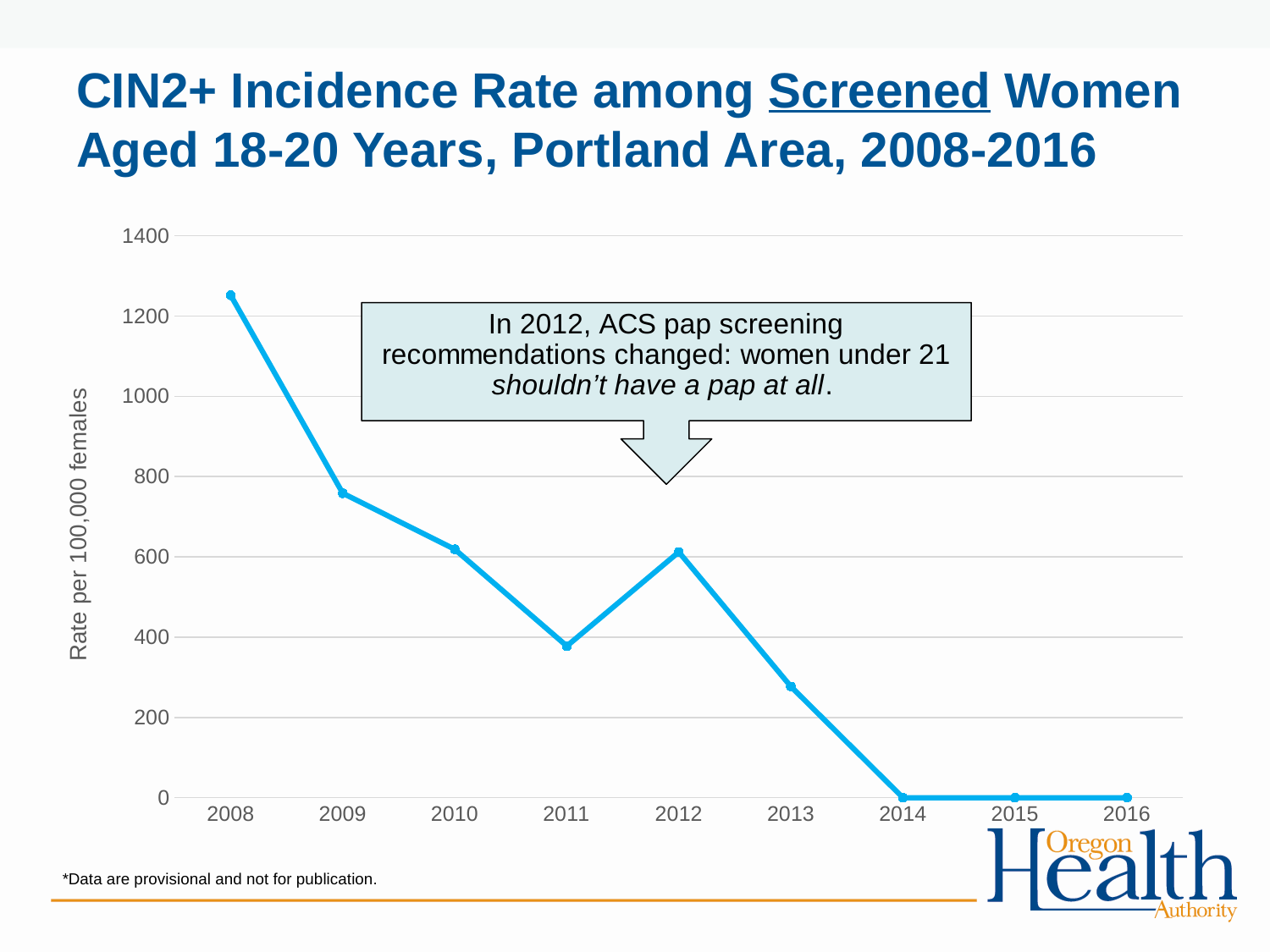
Is the value for 2011 greater or less than 400? less What is the CIN2+ incidence rate for 2016? 0 Is the value for 2013 greater or less than 200? greater Is the value for 2008 greater or less than 1200? greater What is the label on the y axis? Rate per 100,000 females Overall, do the values rise or fall from 2008 to 2016? fall How many years are plotted along the x axis? 9 What is the CIN2+ incidence rate for 2014? 0 What kind of chart is shown on the slide? line chart Which year has the larger value, 2011 or 2012? 2012 Which year has the highest CIN2+ incidence rate? 2008